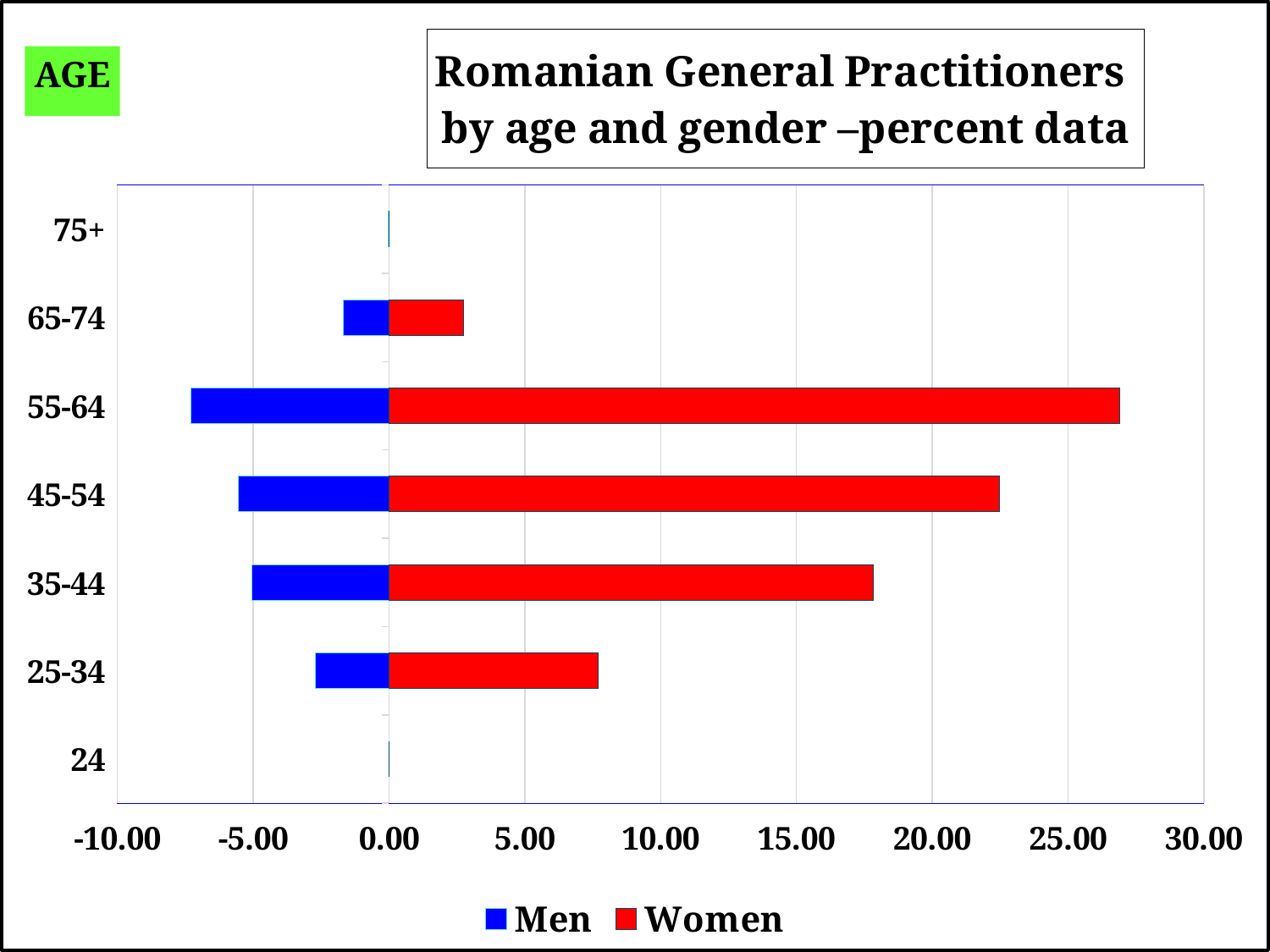
Is the Women value for the 55-64 age group greater or less than 25.00? greater How many age groups are shown on the vertical axis? 7 Is the Women value for the 35-44 age group greater or less than 20.00? less Is the Women value for the 45-54 age group greater or less than 20.00? greater How many series does the legend list? 2 What kind of chart is shown on the slide? Bar chart Which colour represents Women in the chart? Red Which age group has the longest Women bar? 55-64 Which age group has the larger Women value, 45-54 or 35-44? 45-54 Which age group has the longest Men bar? 55-64